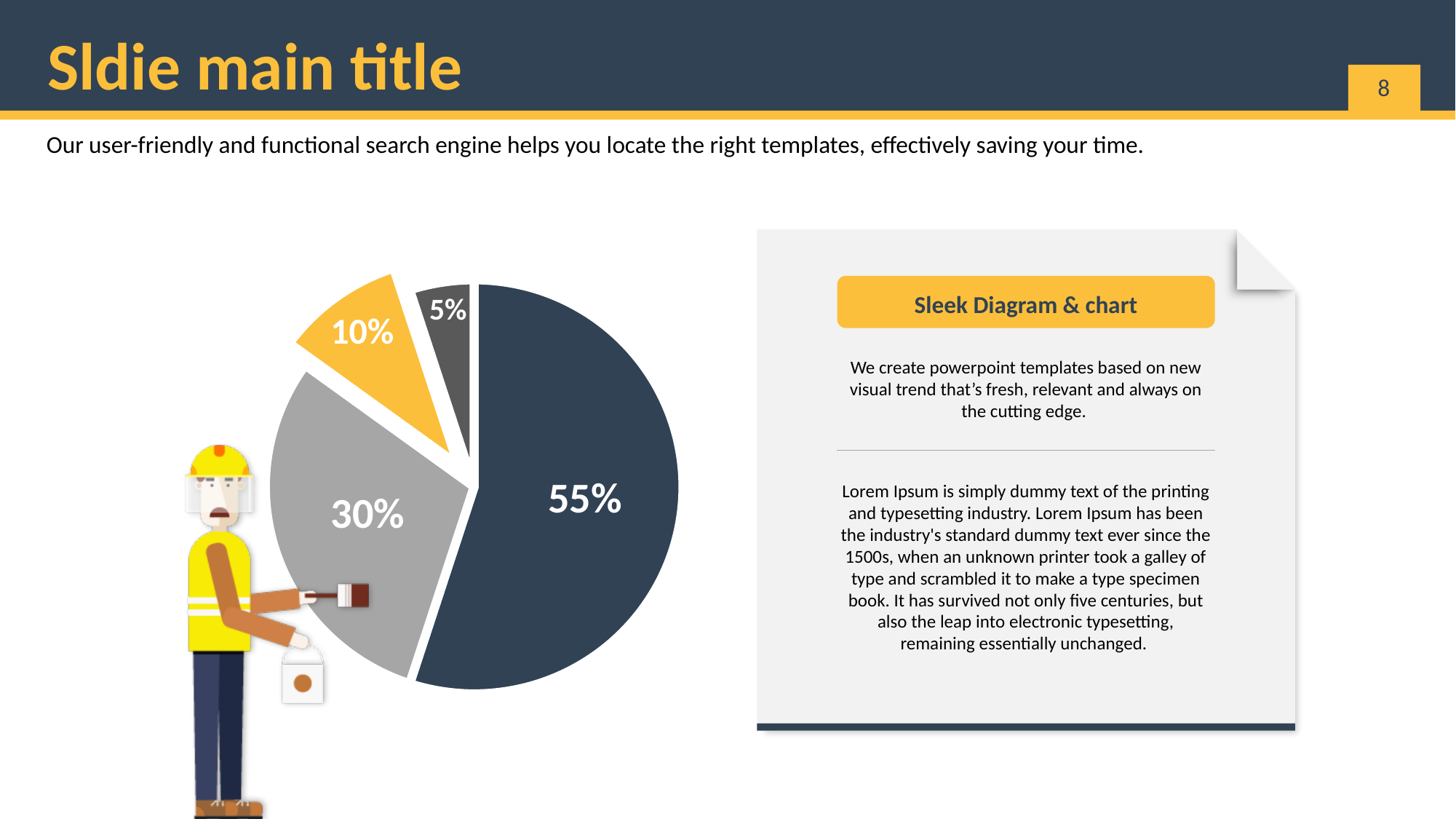
What colour is the largest slice of the pie chart? dark blue What percentage is shown on the light grey slice of the pie chart? 30% What is the value shown on the smallest slice of the pie chart? 5% What is the value shown on the largest slice of the pie chart? 55% What is the difference between the yellow slice and the dark grey slice values in the pie chart? 5% What kind of chart is shown on the slide? pie chart What is the difference between the largest and the second-largest slice values in the pie chart? 25% How many slices does the pie chart have? 4 What percentage is shown on the dark blue slice of the pie chart? 55% Which slice is larger in the pie chart, the yellow slice or the dark grey slice? the yellow slice What percentage is shown on the dark grey slice of the pie chart? 5% What percentage is shown on the yellow slice of the pie chart? 10%